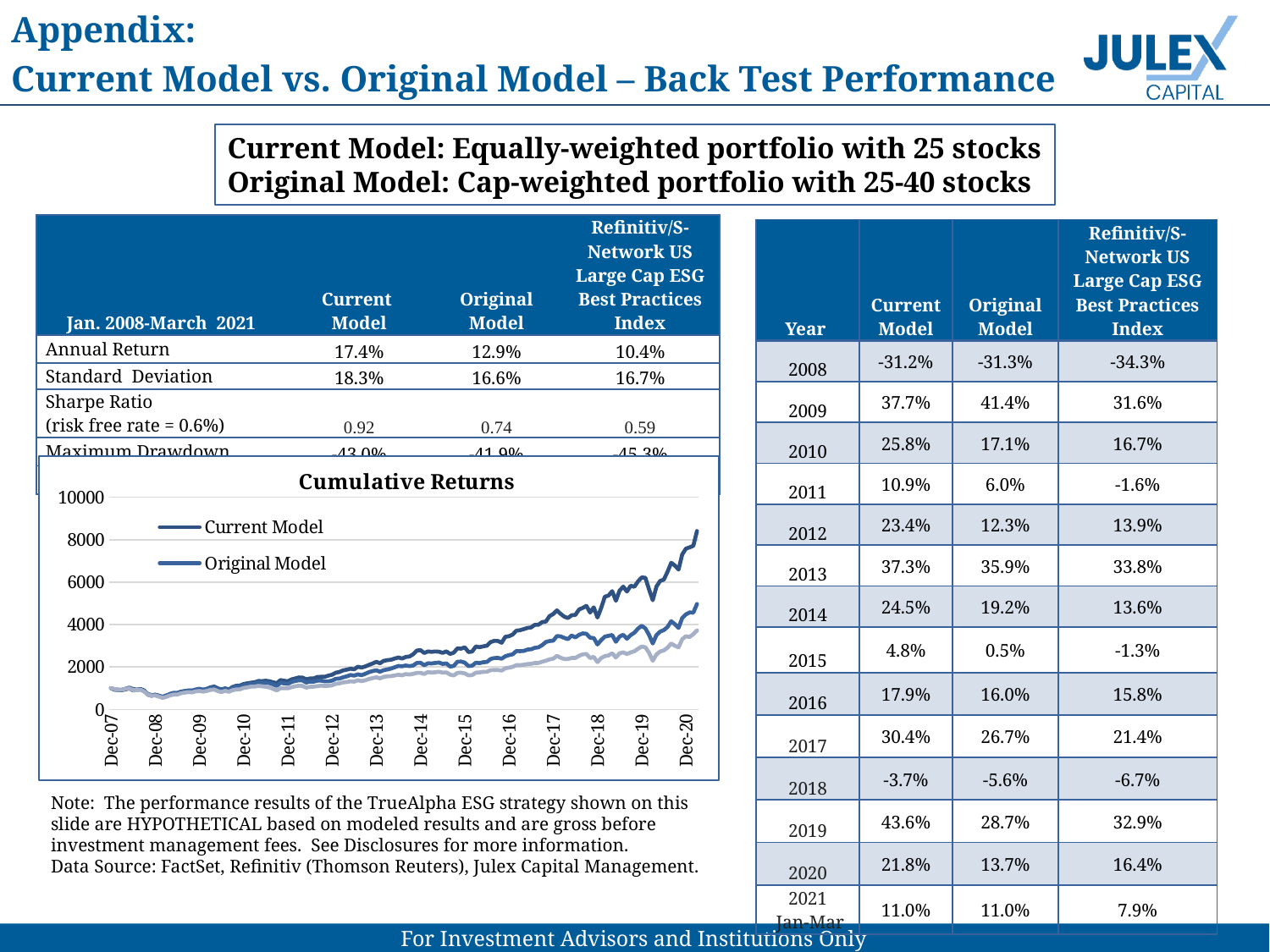
How many date labels are shown on the x axis of the Cumulative Returns chart? 14 In the Cumulative Returns chart, is the value for the Current Model at Dec-15 greater or less than 4000? less What kind of chart is the Cumulative Returns chart? line chart What is the title of the chart on the slide? Cumulative Returns What is the highest value shown on the y axis of the Cumulative Returns chart? 10000 In the Cumulative Returns chart, is the value for the Original Model at Dec-12 greater or less than 2000? less In the Cumulative Returns chart, is the value for the Original Model at Dec-20 greater or less than 6000? less In the Cumulative Returns chart, which series is higher at Dec-20, Current Model or Original Model? Current Model Which two series are named in the legend of the Cumulative Returns chart? Current Model and Original Model In the Cumulative Returns chart, do the values for the Current Model generally rise or fall from Dec-07 to Dec-20? rise How many series does the legend of the Cumulative Returns chart list? 2